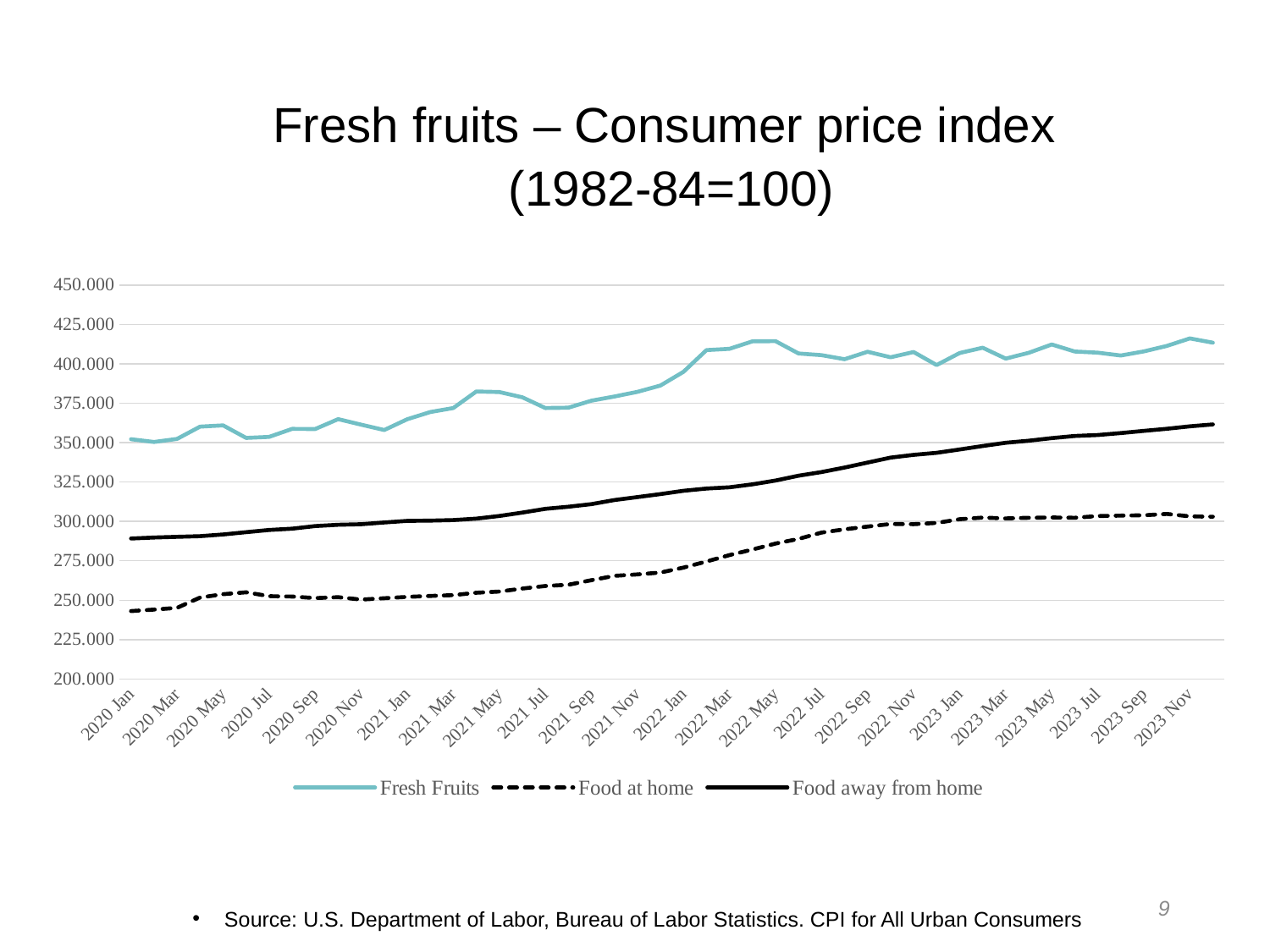
In 2023 Nov, which is larger: Fresh Fruits or Food away from home? Fresh Fruits Which series is drawn as a dashed line? Food at home Is the value for Food away from home in 2020 Jan greater or less than 300.000? less Is the value for Fresh Fruits in 2022 May greater or less than 400.000? greater What kind of chart is shown on the slide? Line chart Does the Food away from home series rise or fall from 2020 Jan to 2023 Nov? Rise Which series has the lowest values across the whole period? Food at home Is the value for Food at home in 2020 Jan greater or less than 250.000? less Which series has the highest values across the whole period? Fresh Fruits What is the title of the chart on the slide? Fresh fruits – Consumer price index (1982-84=100) How many series does the legend list? 3